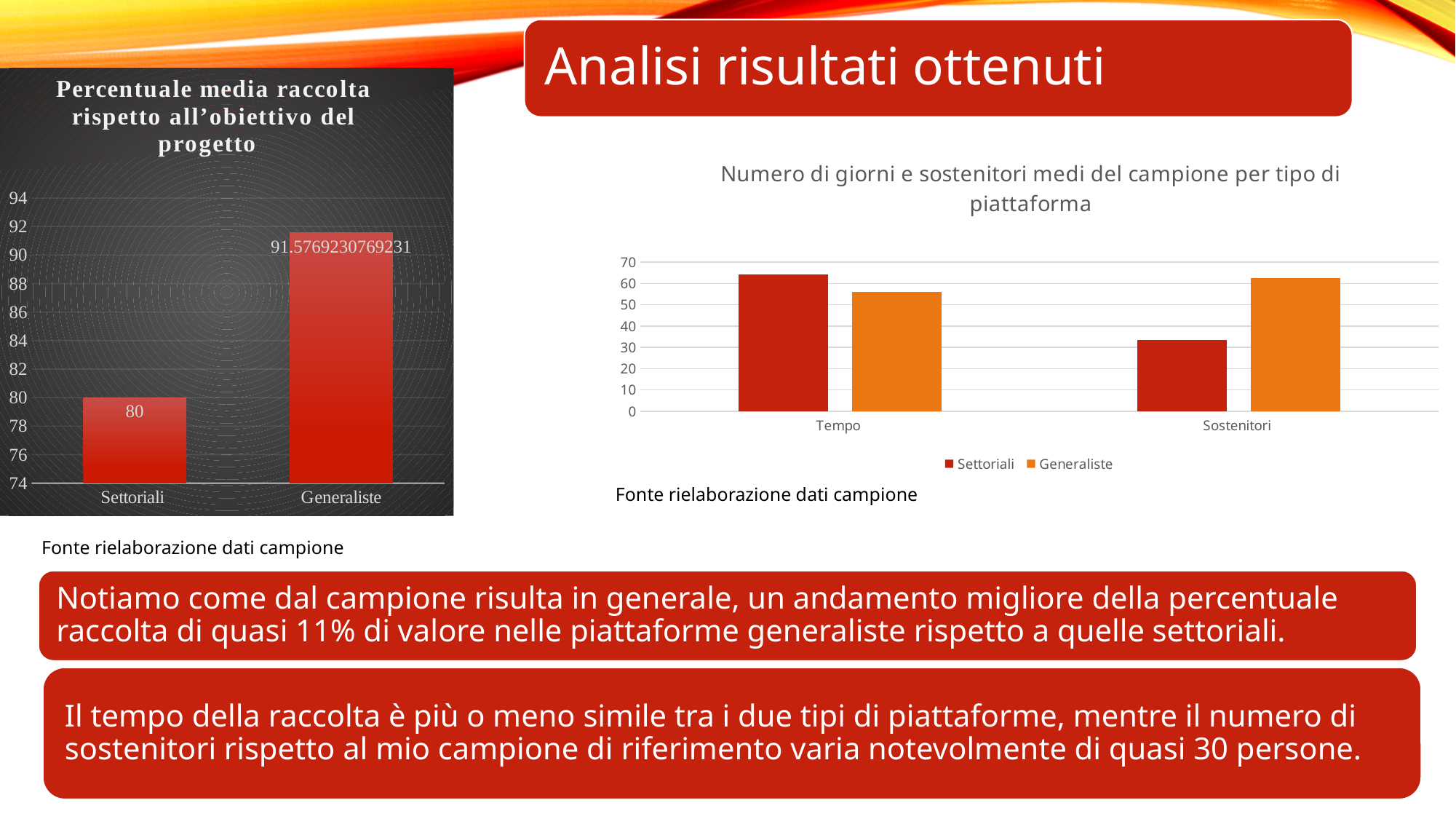
In the right chart 'Numero di giorni e sostenitori medi del campione per tipo di piattaforma', what colour represents the Generaliste series? Orange In the left chart 'Percentuale media raccolta rispetto all'obiettivo del progetto', what is the value for Settoriali? 80 What kind of chart is the right chart 'Numero di giorni e sostenitori medi del campione per tipo di piattaforma'? Bar chart In the left chart 'Percentuale media raccolta rispetto all'obiettivo del progetto', what is the difference between the Generaliste and Settoriali values? 11.5769230769231 In the left chart 'Percentuale media raccolta rispetto all'obiettivo del progetto', how many categories are shown? 2 In the left chart 'Percentuale media raccolta rispetto all'obiettivo del progetto', what is the value for Generaliste? 91.5769230769231 In the right chart 'Numero di giorni e sostenitori medi del campione per tipo di piattaforma', which series has the larger value for Tempo? Settoriali In the right chart 'Numero di giorni e sostenitori medi del campione per tipo di piattaforma', is the Generaliste value for Sostenitori greater or less than 50? greater In the right chart 'Numero di giorni e sostenitori medi del campione per tipo di piattaforma', which series has the larger value for Sostenitori? Generaliste In the left chart 'Percentuale media raccolta rispetto all'obiettivo del progetto', which category has the highest value? Generaliste In the right chart 'Numero di giorni e sostenitori medi del campione per tipo di piattaforma', how many series does the legend list? 2 In the right chart 'Numero di giorni e sostenitori medi del campione per tipo di piattaforma', is the Settoriali value for Sostenitori greater or less than 40? less